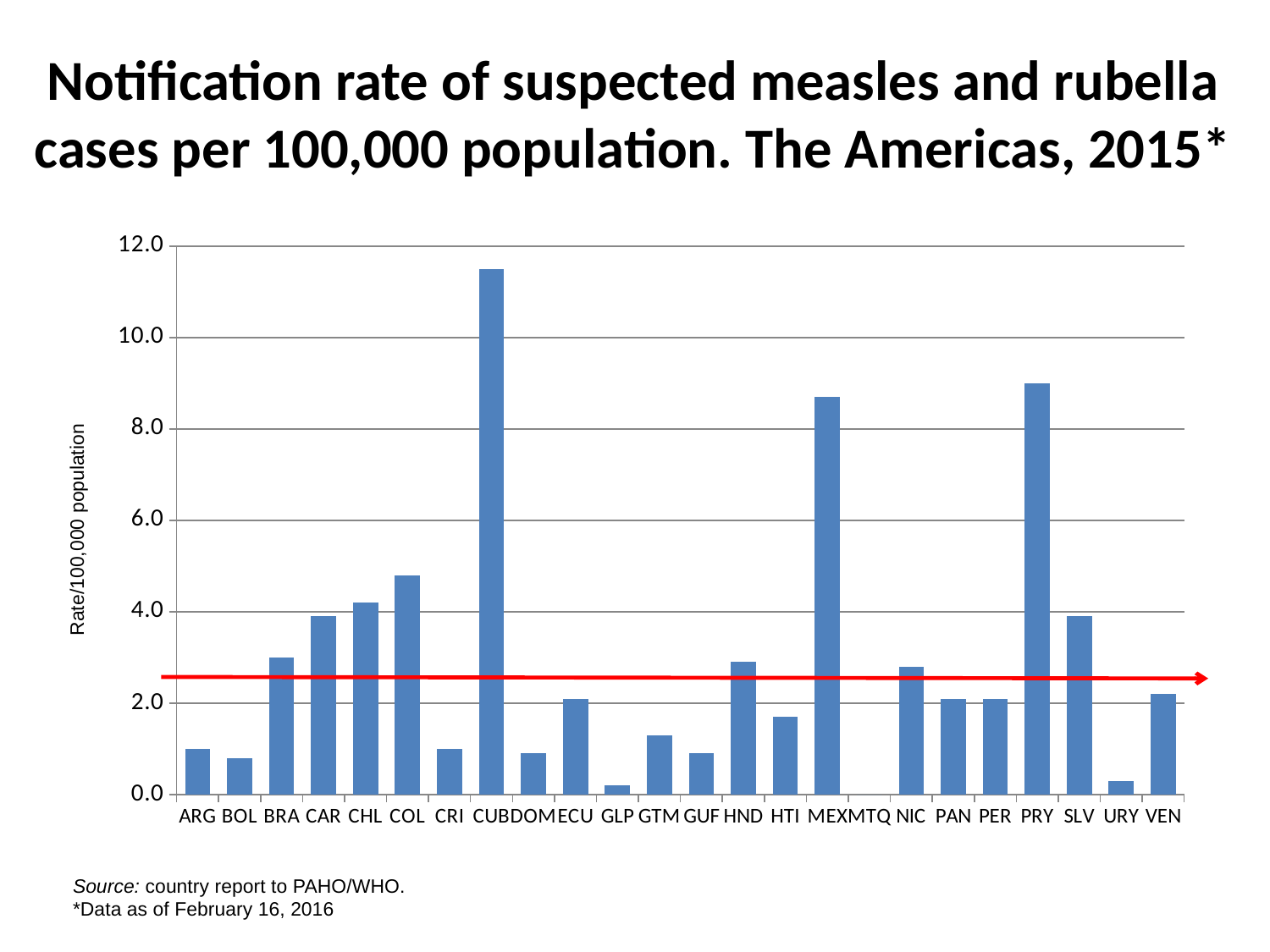
Is the value for MEX greater or less than 8.0? greater Is the value for GLP greater or less than 2.0? less Which country has the highest notification rate? CUB How many countries/territories are shown on the x axis? 24 Is the value for HND greater or less than 4.0? less Which has a higher notification rate, COL or BRA? COL Which has a higher notification rate, CUB or MEX? CUB What kind of chart is shown on the slide? bar chart What is the label on the y axis? Rate/100,000 population